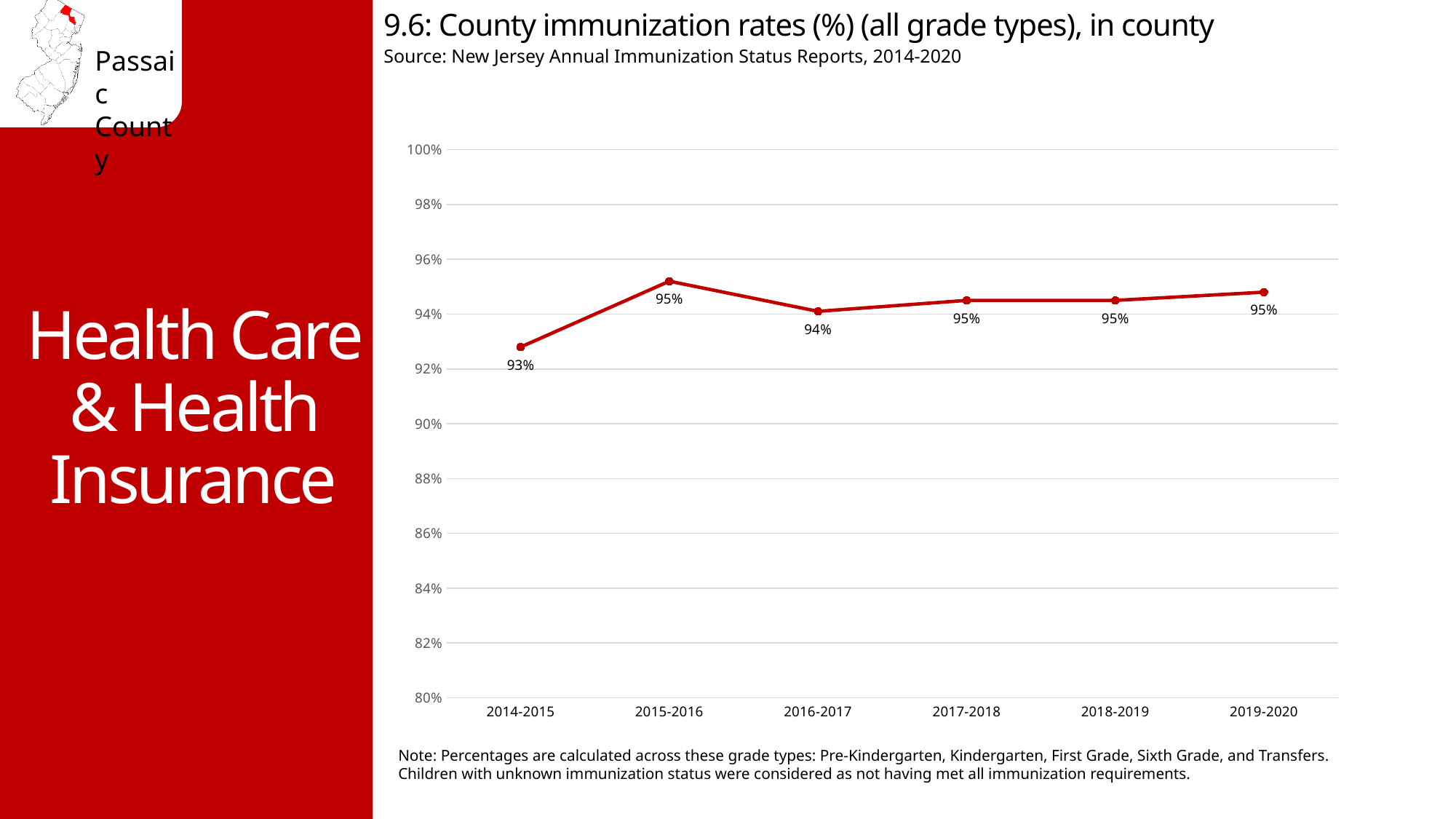
Which is larger, the immunization rate for 2014-2015 or for 2016-2017? 2016-2017 What is the county immunization rate for 2019-2020? 95% Which school year has the lowest immunization rate? 2014-2015 Is the value for 2014-2015 greater or less than 94%? less What is the county immunization rate for 2014-2015? 93% What is the difference between the immunization rate in 2015-2016 and in 2014-2015, using the printed labels? 2 percentage points What is the source cited for the chart? New Jersey Annual Immunization Status Reports, 2014-2020 What type of chart is shown on the slide? Line chart Does the immunization rate rise or fall overall from 2014-2015 to 2019-2020? Rise Is the value for 2015-2016 greater or less than 94%? greater How many school years are plotted on the chart? 6 What is the county immunization rate for 2016-2017? 94%